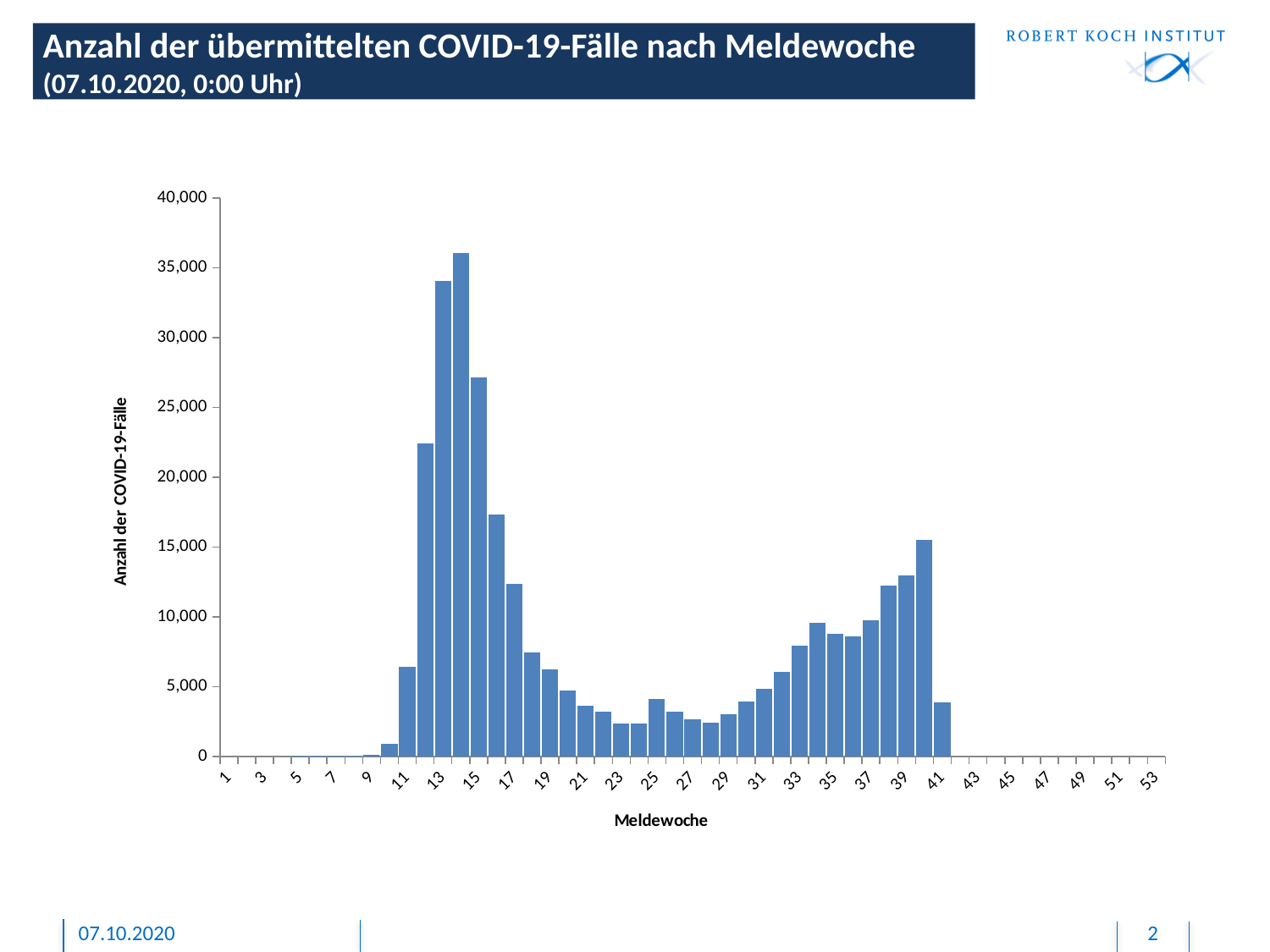
Is the value for Meldewoche 16 greater or less than 15,000? greater Is the value for Meldewoche 24 greater or less than 5,000? less What is the label of the x axis? Meldewoche Which has more cases, Meldewoche 12 or Meldewoche 40? Meldewoche 12 Which has more cases, Meldewoche 13 or Meldewoche 15? Meldewoche 13 Do the values rise or fall from Meldewoche 30 to Meldewoche 40? rise Is the value for Meldewoche 14 greater or less than 30,000? greater Which Meldewoche has the highest number of COVID-19 cases? 14 Do the values rise or fall from Meldewoche 14 to Meldewoche 24? fall What kind of chart is shown on the slide? bar chart